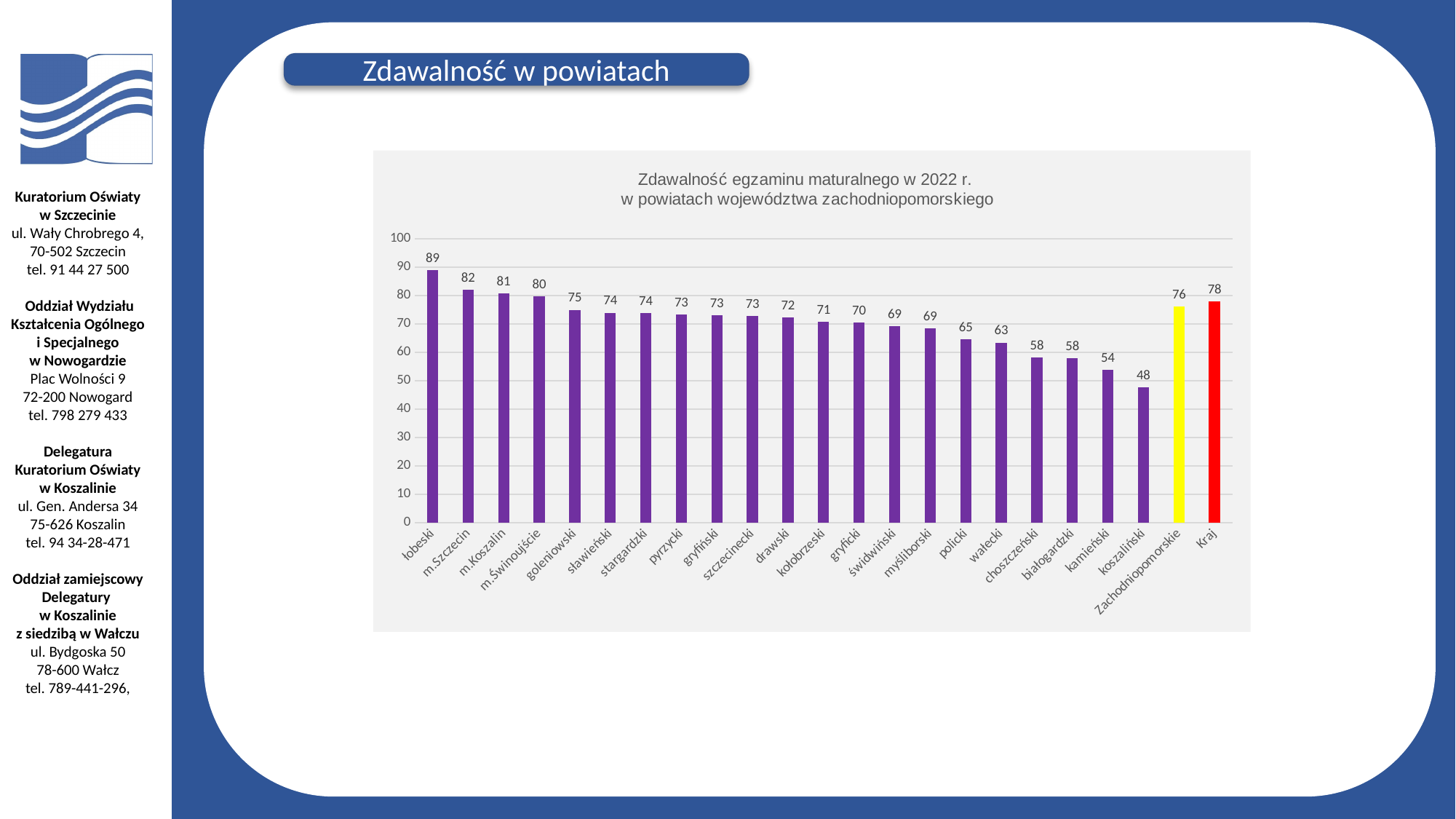
Which category has the highest value? łobeski How many bars are shown in the chart? 23 Which category has the lowest value? koszaliński What is the difference between the values for łobeski and koszaliński? 41 What kind of chart is shown on the slide? bar chart What is the difference between the values for Kraj and Zachodniopomorskie? 2 What colour is the bar for Kraj? red Which is larger, the value for m.Szczecin or the value for m.Koszalin? m.Szczecin What is the value for kamieński? 54 What is the value for łobeski? 89 What is the value for Zachodniopomorskie? 76 What is the value for Kraj? 78